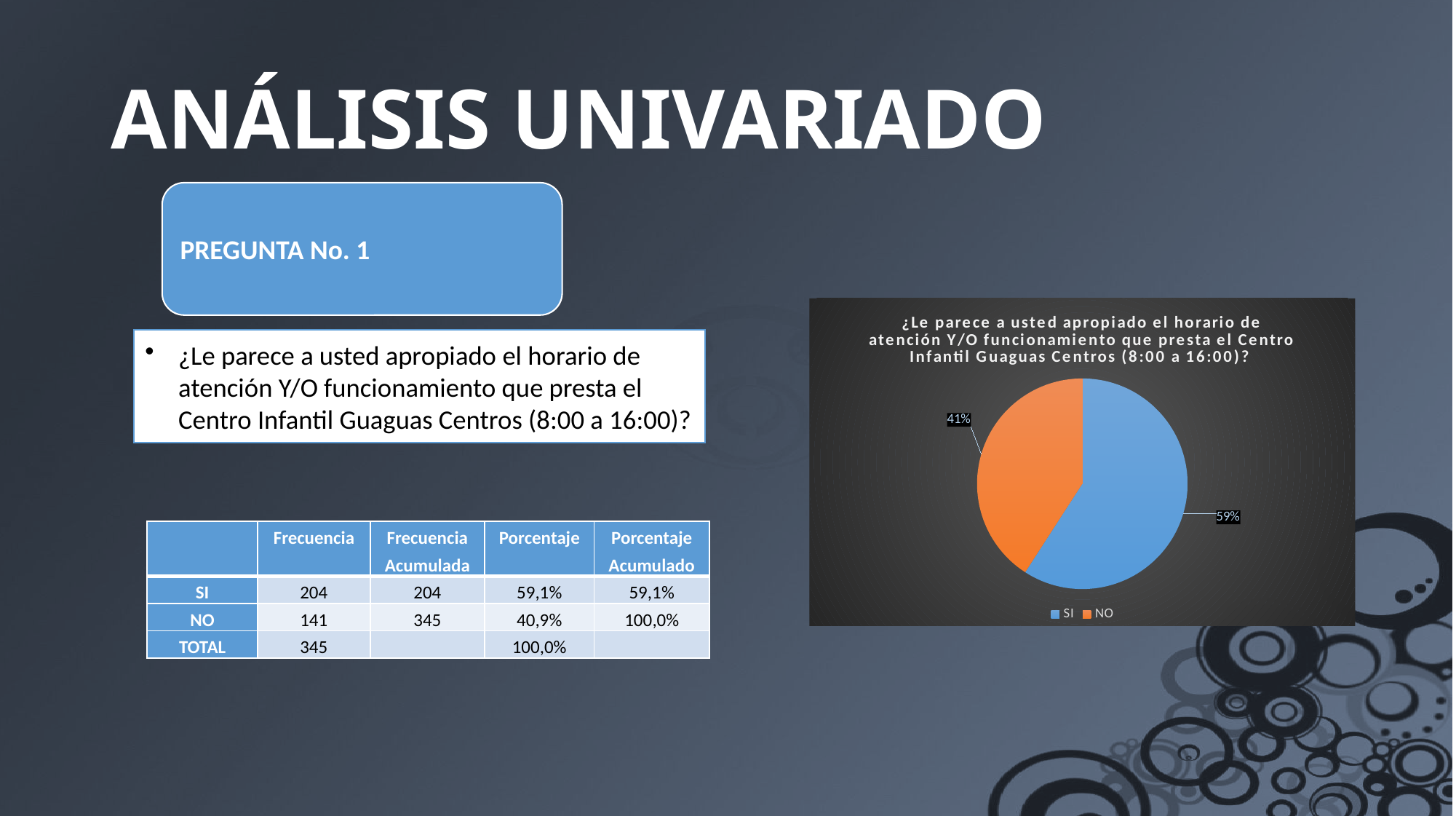
By how many percentage points does the SI slice exceed the NO slice in the pie chart? 18% What percentage does the pie chart show for NO? 41% What kind of chart is shown on the slide? Pie chart What colour is the SI slice in the pie chart? Blue What colour is the NO slice in the pie chart? Orange What share of the pie does the SI slice represent? 59% How many entries does the pie chart's legend list? 2 Which category has the smallest slice in the pie chart? NO What percentage does the pie chart show for SI? 59% How many slices does the pie chart have? 2 Which category has the largest slice in the pie chart? SI Which slice is larger in the pie chart, SI or NO? SI